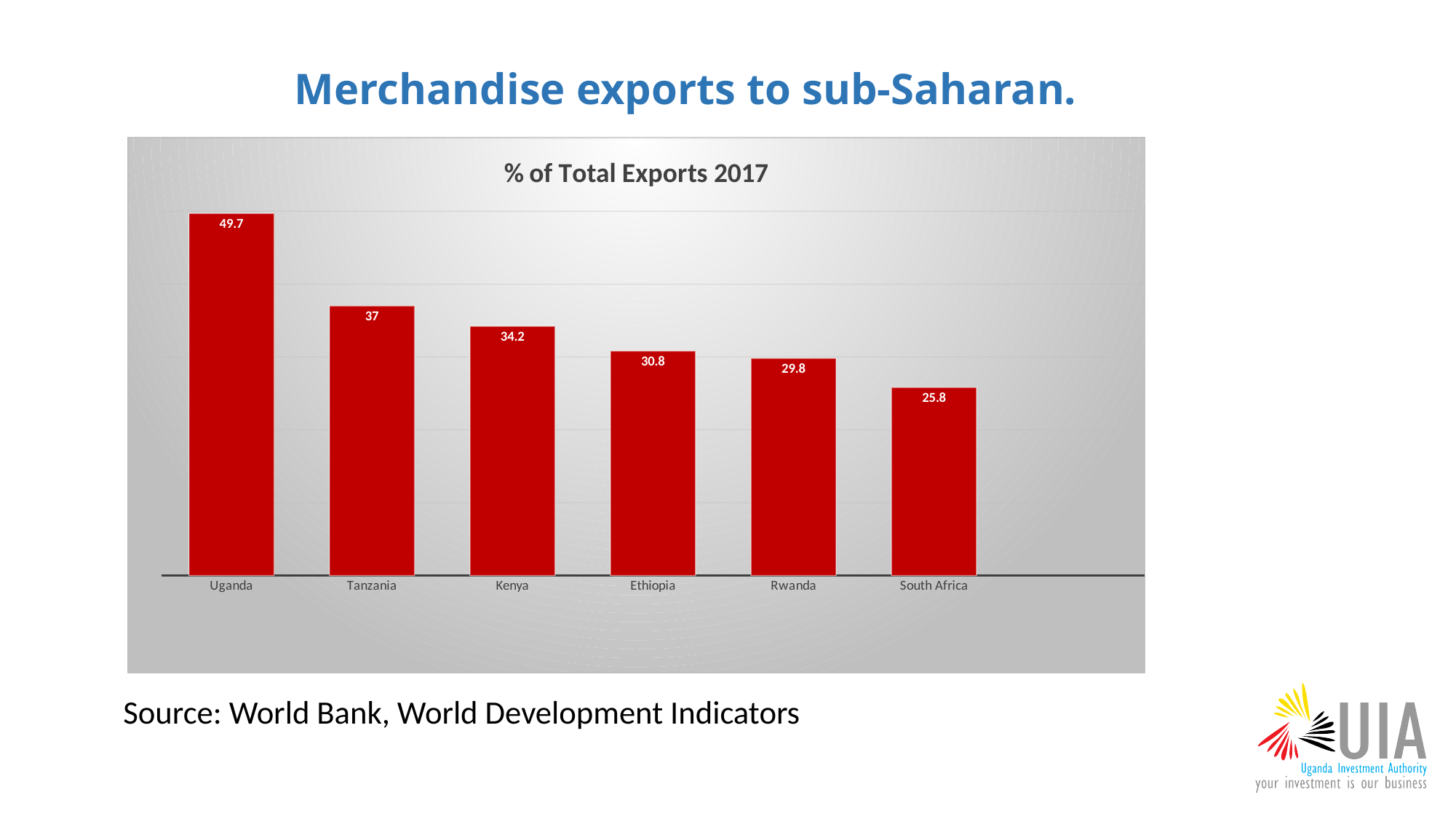
Do the values rise or fall from left to right along the x axis? Fall Which country has the lowest value? South Africa What is the difference between the values for Ethiopia and Rwanda? 1 What kind of chart is shown on the slide? Bar chart What is the value for Kenya? 34.2 Which country has the highest value? Uganda What is the value for Uganda? 49.7 Which is larger, the value for Kenya or the value for Rwanda? Kenya What is the title shown inside the chart area? % of Total Exports 2017 What is the value for South Africa? 25.8 What is the difference between the values for Uganda and Tanzania? 12.7 How many countries are shown on the chart? 6